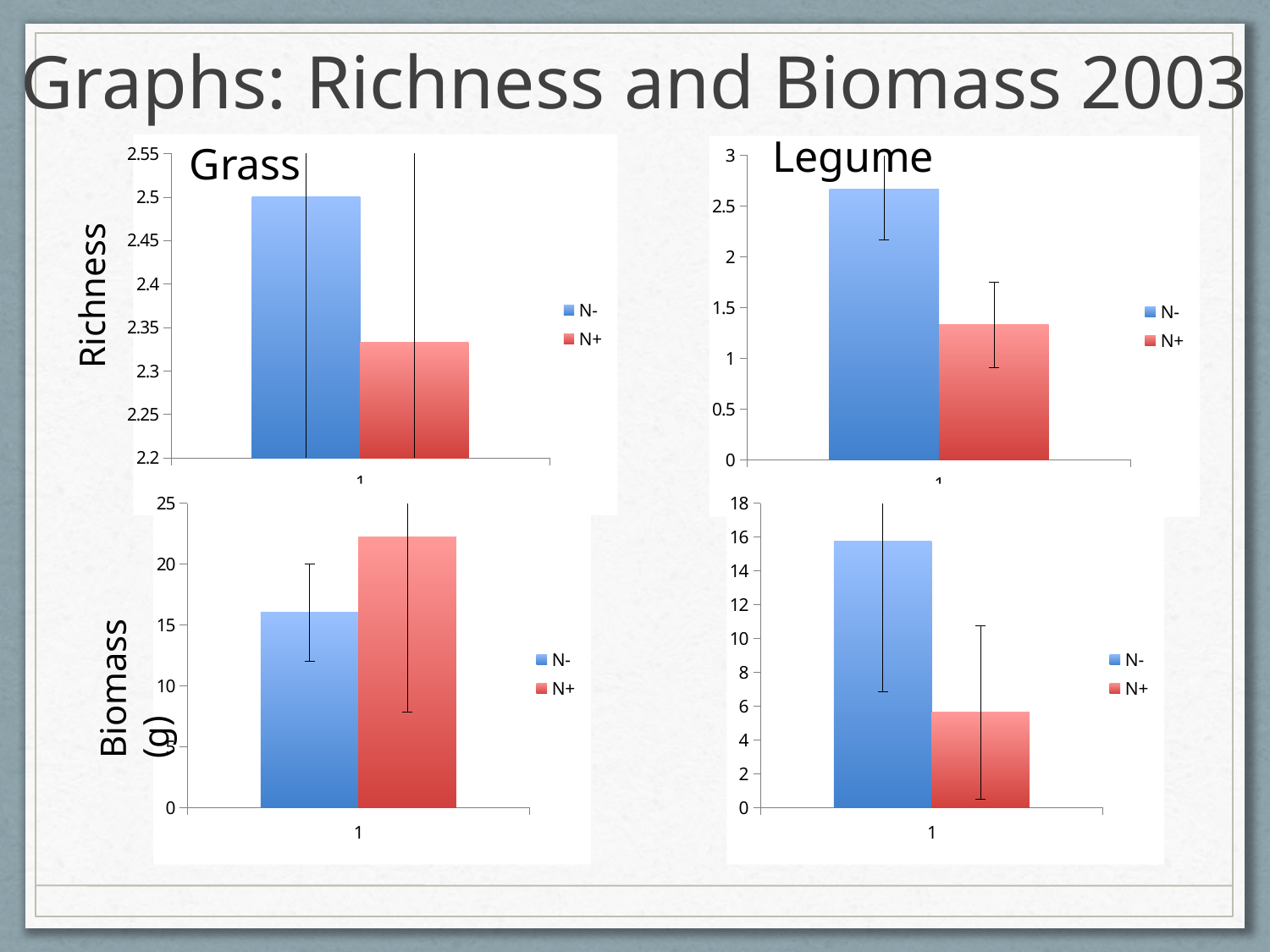
In the Legume Biomass chart (bottom-right), which series has the taller bar, N- or N+? N- In the Grass Richness chart (top-left), which series has the taller bar, N- or N+? N- In the Legume Richness chart (top-right), is the value for N- greater or less than 2.5? greater In the Grass Biomass chart (bottom-left), which series has the taller bar, N- or N+? N+ How many series does the legend of the Grass Richness chart (top-left) list? 2 In the Legume Richness chart (top-right), is the value for N+ greater or less than 1.5? less In the Grass Biomass chart (bottom-left), is the value for N+ greater or less than 20? greater What kind of chart is the Legume Biomass chart (bottom-right)? Bar chart In the Grass Biomass chart (bottom-left), what colour represents the N+ series? Red